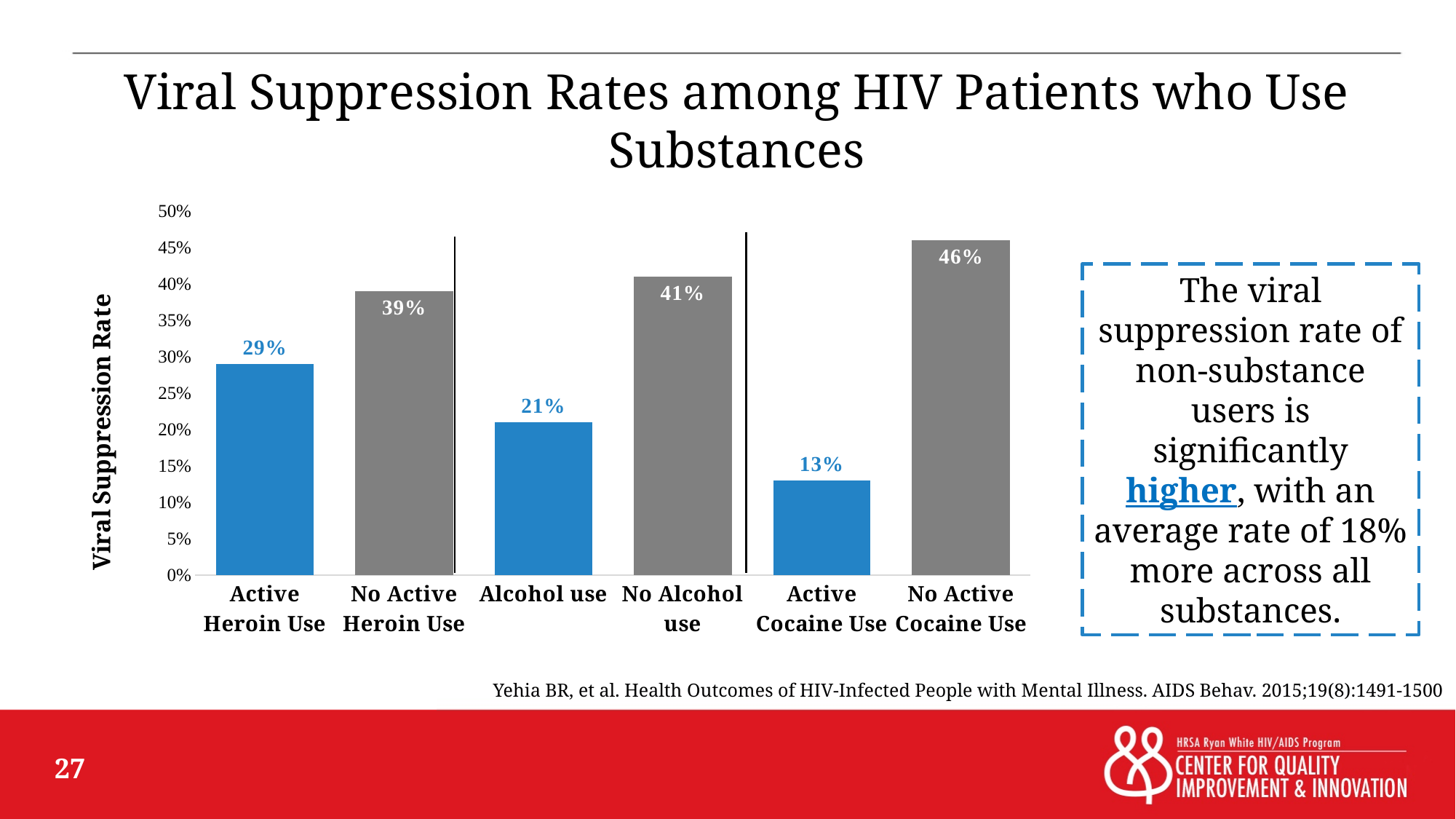
How many categories are shown on the x axis of the chart? 6 What is the difference in viral suppression rate between No Active Heroin Use and Active Heroin Use? 10% What is the viral suppression rate for Active Cocaine Use? 13% Which has a higher viral suppression rate, Alcohol use or Active Heroin Use? Active Heroin Use What is the viral suppression rate for Active Heroin Use? 29% Is the viral suppression rate for No Alcohol use greater or less than 40%? greater What is the viral suppression rate for No Alcohol use? 41% What kind of chart is shown on the slide? Bar chart What is the label of the vertical axis of the chart? Viral Suppression Rate Which category has the highest viral suppression rate? No Active Cocaine Use What is the difference in viral suppression rate between No Active Cocaine Use and Active Cocaine Use? 33% Which category has the lowest viral suppression rate? Active Cocaine Use